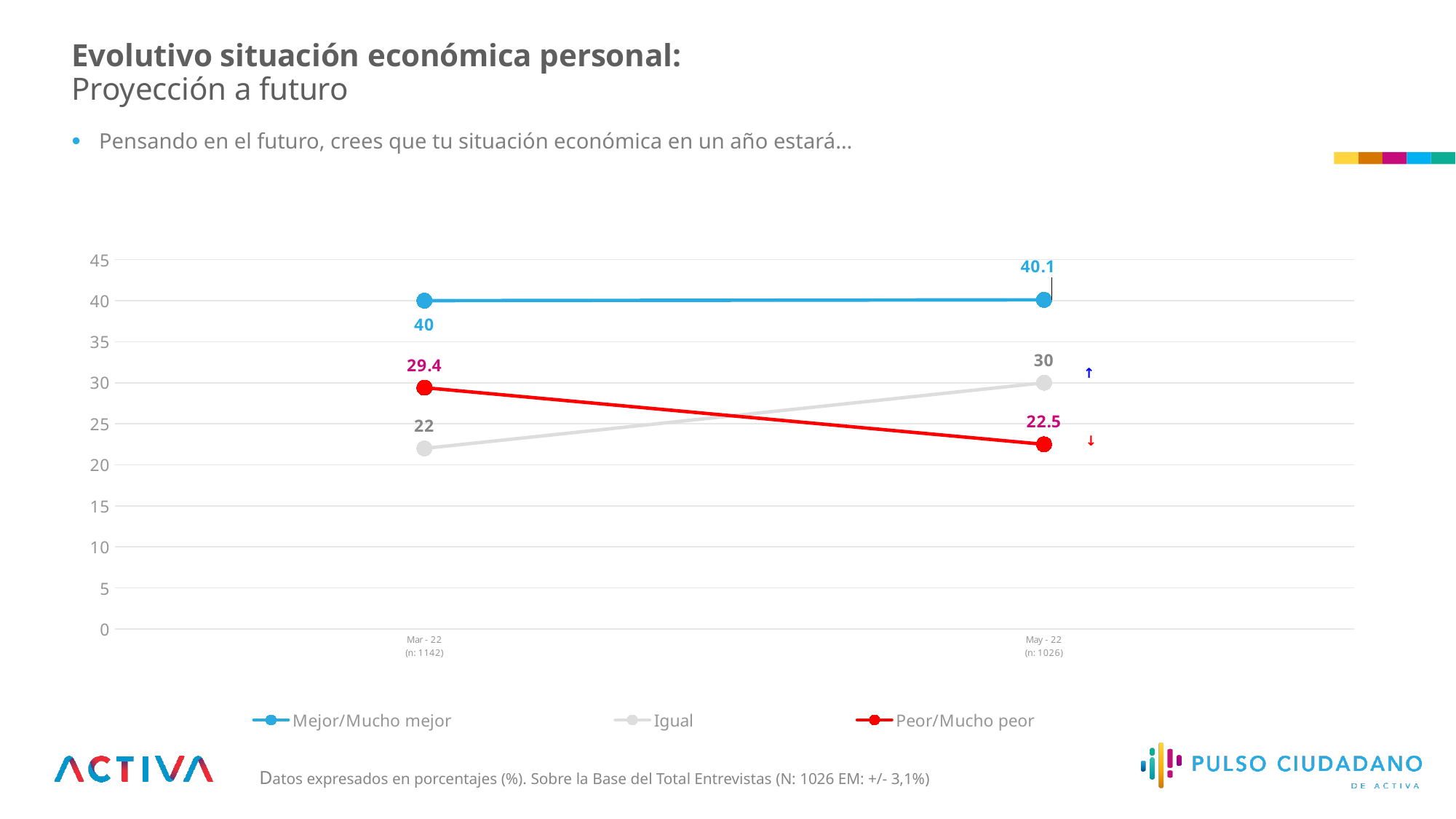
Which is larger in May - 22: Igual or Peor/Mucho peor? Igual By how much did the Igual series change from Mar - 22 to May - 22? 8 What is the value for Peor/Mucho peor in May - 22? 22.5 What is the value for Mejor/Mucho mejor in May - 22? 40.1 How many time points are plotted on the x axis? 2 What is the value for Igual in Mar - 22? 22 Which series has the highest value in May - 22? Mejor/Mucho mejor What is the value for Peor/Mucho peor in Mar - 22? 29.4 What kind of chart is shown on the slide? line chart Does the Peor/Mucho peor series rise or fall from Mar - 22 to May - 22? fall How many series does the legend list? 3 Which series has the lowest value in Mar - 22? Igual